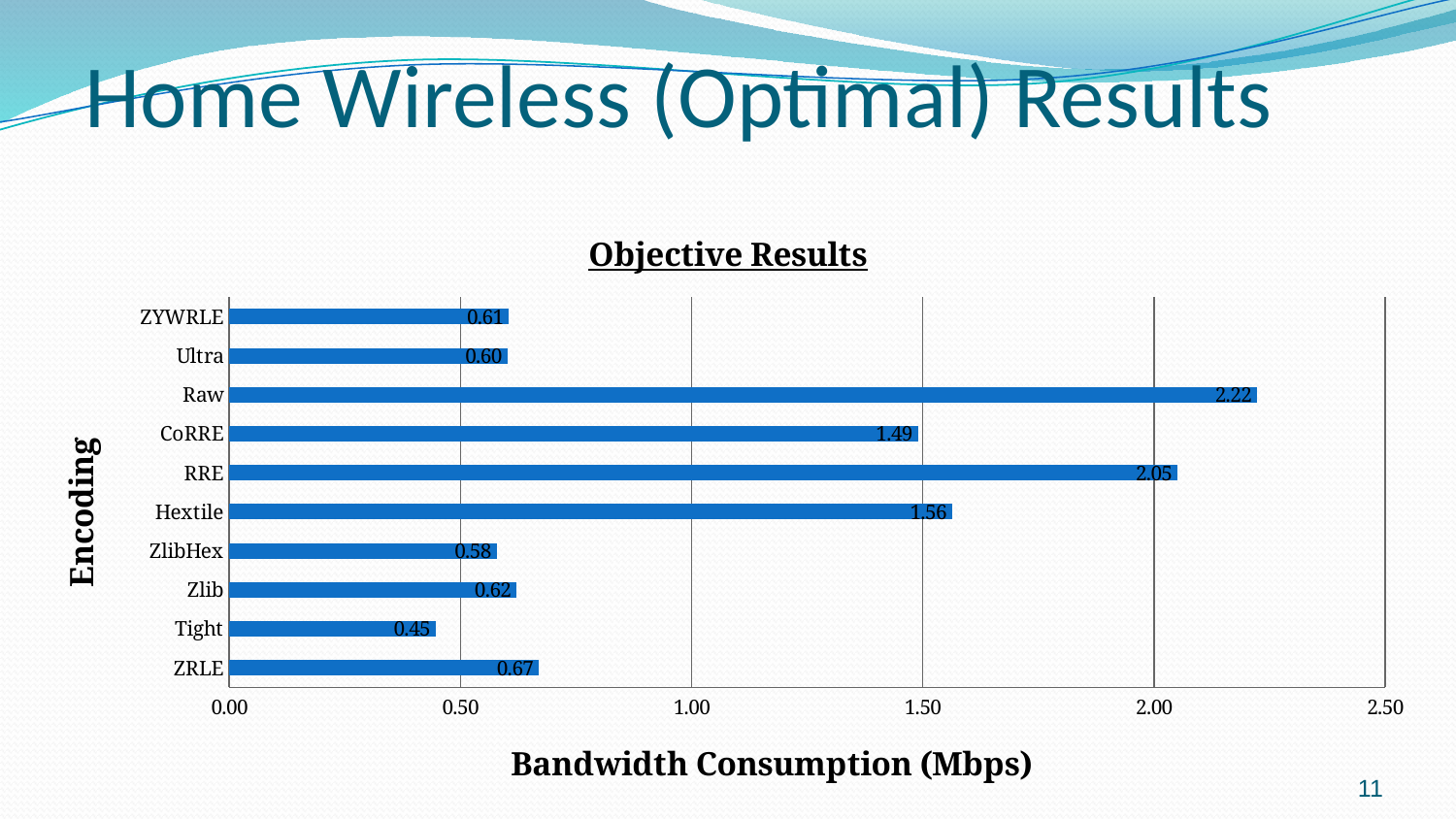
What is the bandwidth consumption for the Hextile encoding? 1.56 What is the bandwidth consumption for the Tight encoding? 0.45 Which encoding has the highest bandwidth consumption? Raw What is the label of the horizontal axis? Bandwidth Consumption (Mbps) How many encodings are shown in the chart? 10 Which encoding has the lowest bandwidth consumption? Tight What is the difference in bandwidth consumption between RRE and CoRRE? 0.56 What kind of chart is shown on the slide? Bar chart Is the value for Hextile greater or less than 1.50? greater Which has higher bandwidth consumption, Zlib or ZlibHex? Zlib What is the title of the chart? Objective Results What is the bandwidth consumption for the Raw encoding? 2.22